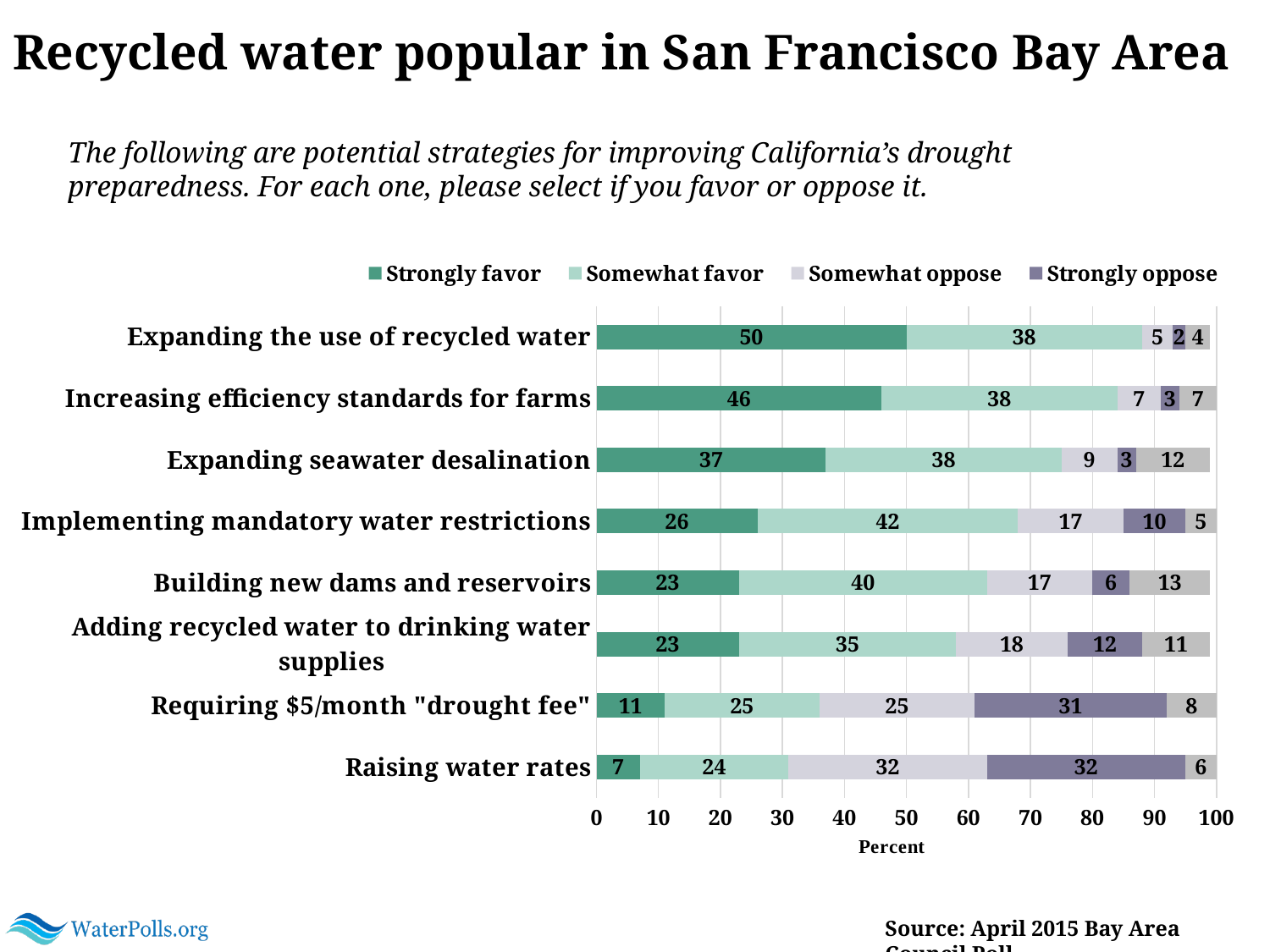
What kind of chart is shown on the slide? Stacked bar chart What is the difference between the Strongly favor values for Expanding the use of recycled water and Expanding seawater desalination? 13 What is the label on the horizontal axis? Percent Which strategy has the highest Strongly favor value? Expanding the use of recycled water How many series does the legend list? 4 What is the Strongly favor value for Expanding the use of recycled water? 50 What is the Strongly oppose value for Requiring $5/month "drought fee"? 31 Which strategy has the lowest Strongly favor value? Raising water rates Which is larger: the Somewhat favor value for Implementing mandatory water restrictions or for Building new dams and reservoirs? Implementing mandatory water restrictions What is the combined Strongly favor and Somewhat favor value for Increasing efficiency standards for farms? 84 How many strategies (categories) are plotted on the chart? 8 What is the Somewhat oppose value for Raising water rates? 32